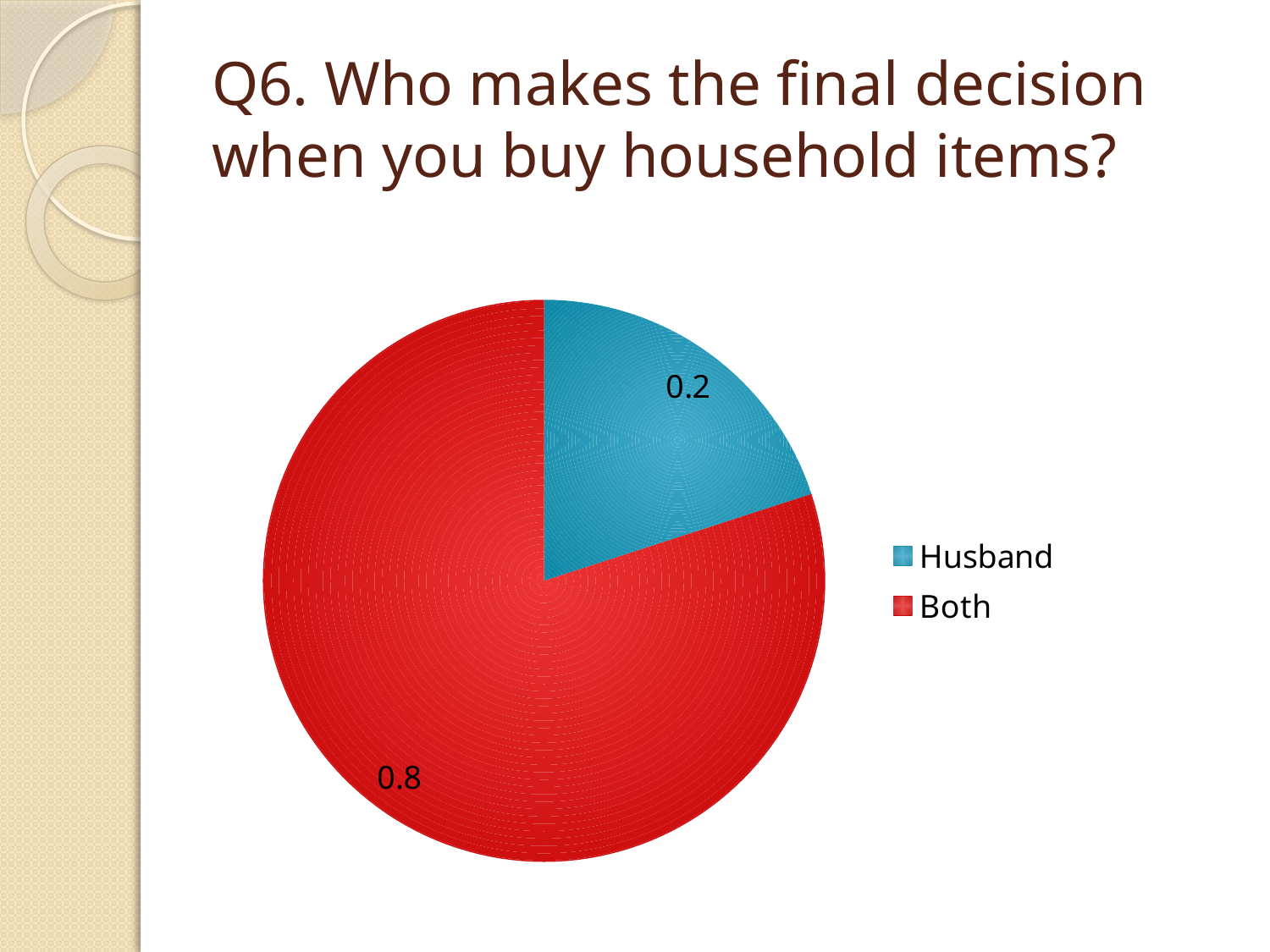
Which is larger, the value for Husband or the value for Both? Both What is the total of the two slice values? 1 Which category has the smallest slice? Husband How many entries does the legend list? 2 What is the title of the slide containing the chart? Q6. Who makes the final decision when you buy household items? What is the value for Both? 0.8 Which category has the largest slice? Both How many categories does the pie chart show? 2 What is the difference between the values for Both and Husband? 0.6 What kind of chart is shown on the slide? pie chart What is the value for Husband? 0.2 What colour is the Both slice? red